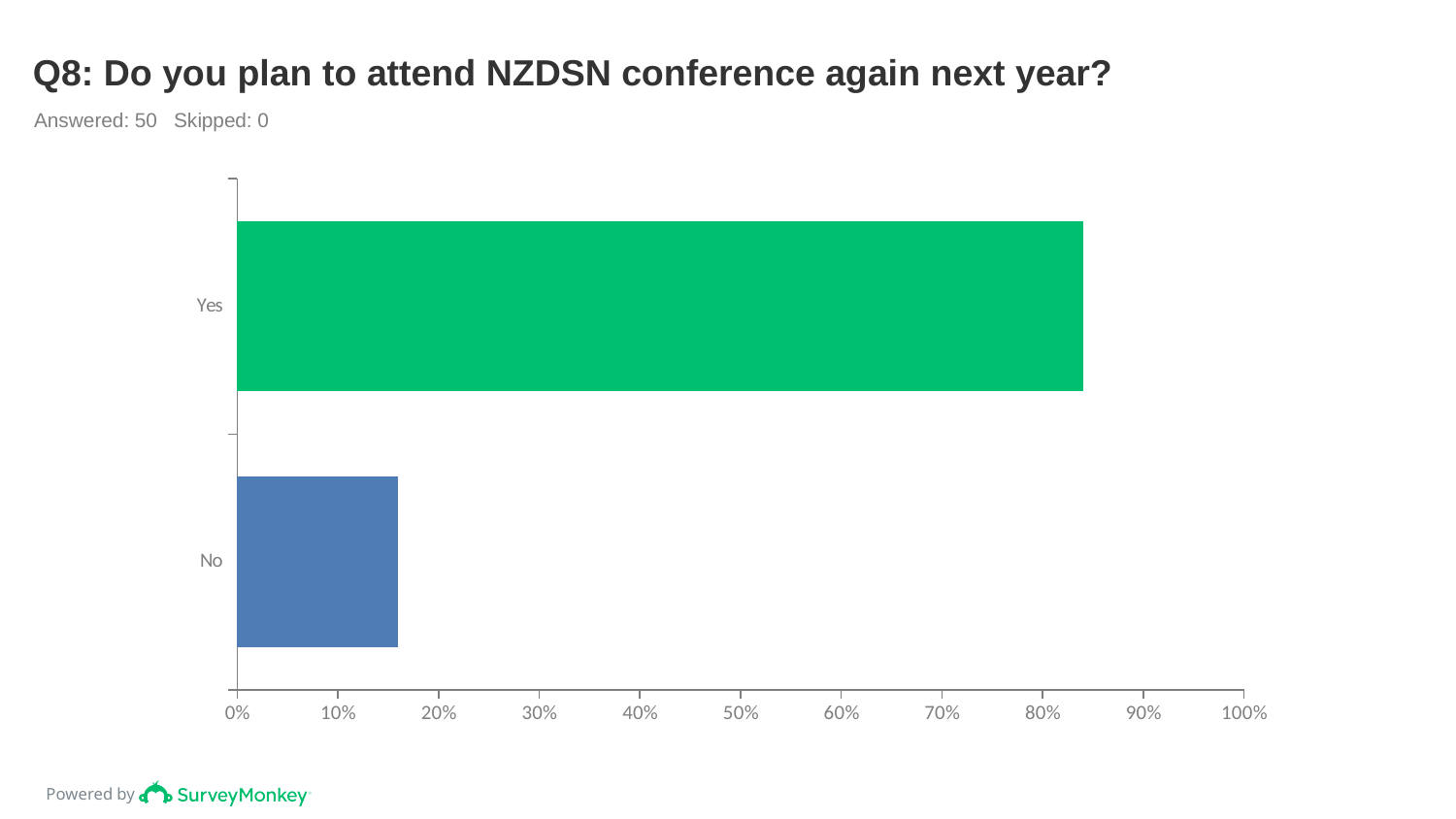
What kind of chart is shown on the slide? bar chart Is the value for Yes greater or less than 90%? less What is the title of the chart? Q8: Do you plan to attend NZDSN conference again next year? Which is larger, the value for Yes or the value for No? Yes Which category has the highest value? Yes How many respondents answered the question according to the slide? 50 Is the value for Yes greater or less than 80%? greater Is the value for No greater or less than 20%? less How many categories are plotted in the chart? 2 Which category has the lowest value? No